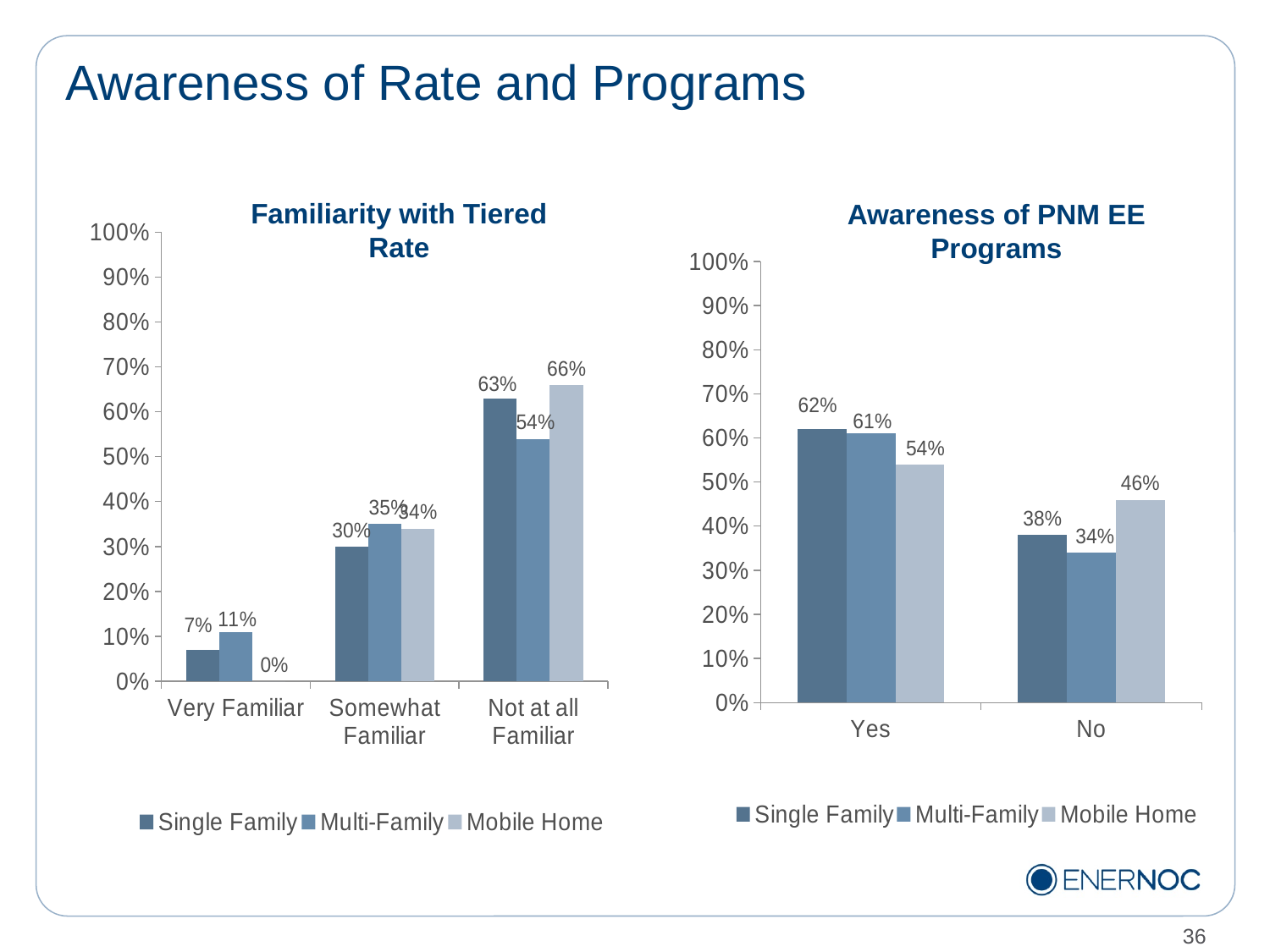
In the 'Awareness of PNM EE Programs' chart, which series has the highest value in the Yes category? Single Family What kind of chart is the 'Awareness of PNM EE Programs' chart? Bar chart In the 'Familiarity with Tiered Rate' chart, do the Single Family values rise or fall from Very Familiar to Not at all Familiar? Rise How many series does the legend of the 'Awareness of PNM EE Programs' chart list? 3 In the 'Awareness of PNM EE Programs' chart, which is larger in the No category: Single Family or Mobile Home? Mobile Home In the 'Familiarity with Tiered Rate' chart, what is the difference between Single Family and Multi-Family in the Not at all Familiar category? 9% In the 'Familiarity with Tiered Rate' chart, what is the value for Mobile Home in the Not at all Familiar category? 66% In the 'Awareness of PNM EE Programs' chart, what is the difference between the Mobile Home values for Yes and No? 8% In the 'Awareness of PNM EE Programs' chart, what is the value for Multi-Family in the No category? 34% How many categories are shown on the x axis of the 'Familiarity with Tiered Rate' chart? 3 In the 'Familiarity with Tiered Rate' chart, what is the value for Single Family in the Very Familiar category? 7% In the 'Familiarity with Tiered Rate' chart, which series has the lowest value in the Very Familiar category? Mobile Home